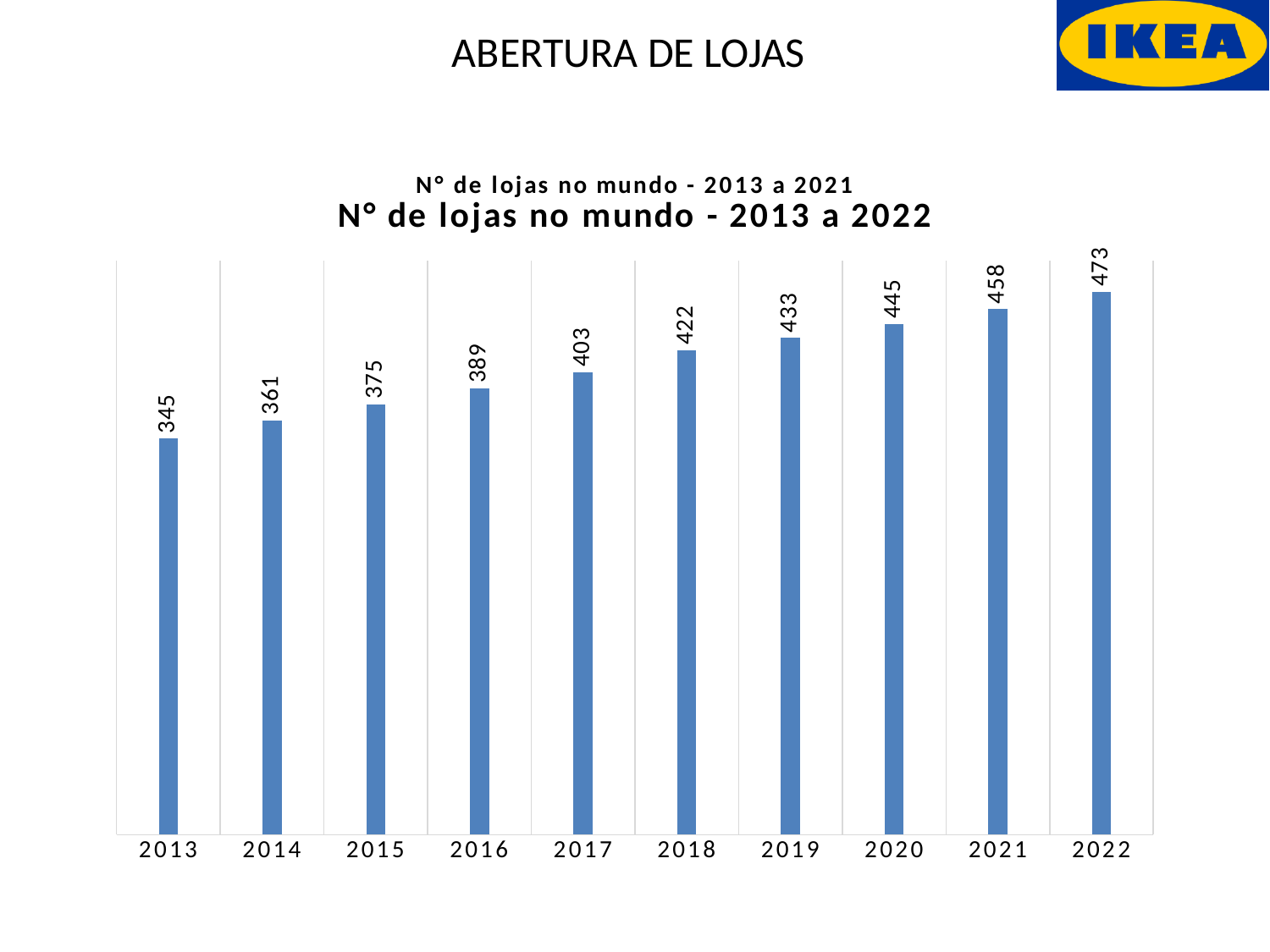
Which year has the lowest number of stores? 2013 What kind of chart is shown on the slide? Bar chart What is the number of stores shown for 2022? 473 Which year has more stores, 2019 or 2020? 2020 What is the difference between the number of stores in 2022 and in 2013? 128 Do the values rise or fall from 2013 to 2022? Rise Which year has the highest number of stores? 2022 What is the number of stores shown for 2018? 422 What is the title of the chart in bold? N° de lojas no mundo - 2013 a 2022 What is the number of stores shown for 2013? 345 How many years are shown on the x axis of the chart? 10 What is the difference between the number of stores in 2017 and in 2016? 14